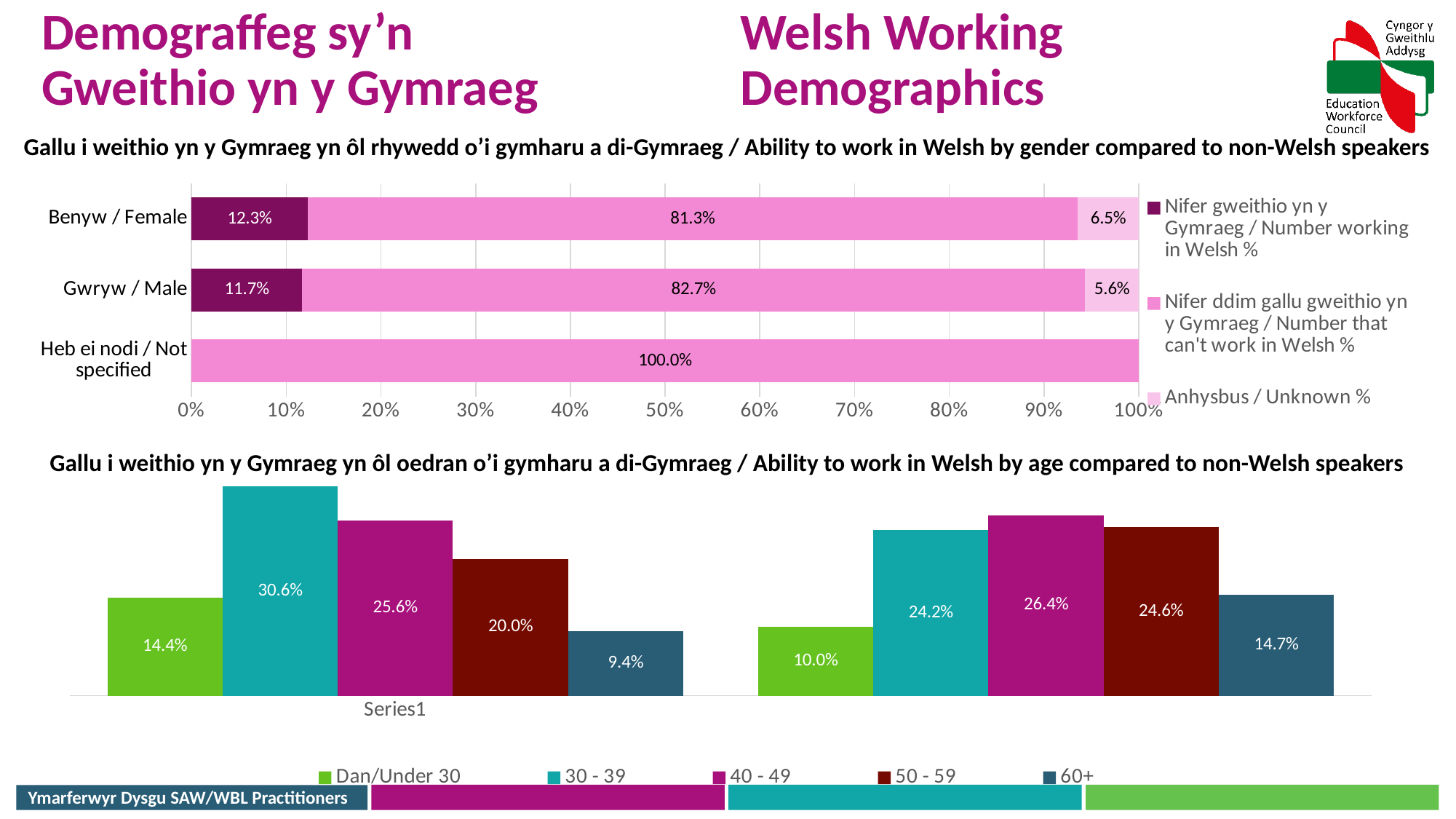
In the bottom chart (ability to work in Welsh by age), what is the difference between the 60+ values in the right and left groups of bars? 5.3% What type of chart is the top chart (ability to work in Welsh by gender)? Stacked bar chart In the bottom chart (ability to work in Welsh by age), which age group has the highest value in the right group of bars? 40 - 49 In the top chart (ability to work in Welsh by gender), what is the difference between the female and male percentages working in Welsh? 0.6% In the top chart (ability to work in Welsh by gender), which gender has the higher Unknown percentage, Female or Male? Benyw / Female In the top chart (ability to work in Welsh by gender), what percentage of males cannot work in Welsh? 82.7% In the bottom chart (ability to work in Welsh by age), which age group has the lowest value in the left group of bars? 60+ In the top chart (ability to work in Welsh by gender), what value is shown for Heb ei nodi / Not specified? 100.0% In the top chart (ability to work in Welsh by gender), what is the Unknown percentage for Benyw / Female? 6.5% In the bottom chart (ability to work in Welsh by age), what is the value for the 30 - 39 age group in the left group of bars? 30.6% In the top chart (ability to work in Welsh by gender), how many series does the legend list? 3 In the top chart (ability to work in Welsh by gender), what percentage of females are recorded as working in Welsh? 12.3%